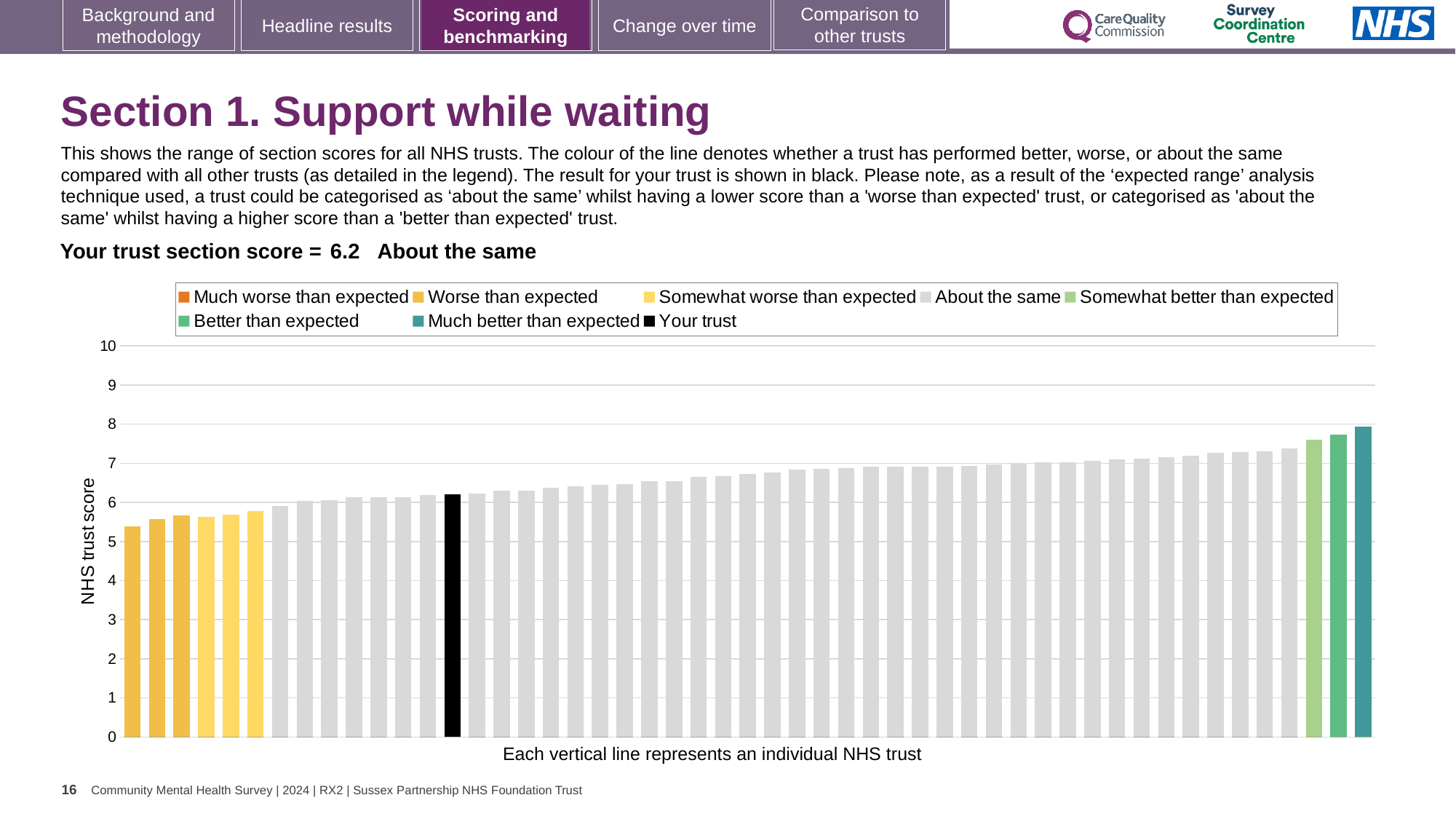
Is the value of the shortest bar in the chart greater or less than 6? less What colour is the bar representing your trust? Black Which legend category does the tallest bar in the chart belong to? Much better than expected What type of chart is shown on the slide? Bar chart Which benchmarking category is your trust's section score placed in? About the same Is the value of the black 'Your trust' bar greater or less than 6? greater What is the section score for your trust shown on the slide? 6.2 How many entries does the chart legend list? 8 How many bars are coloured in the 'Worse than expected' yellow shade? 3 What is the label on the vertical axis of the chart? NHS trust score Is the value of the tallest bar in the chart greater or less than 7? greater Do the bar values rise or fall moving from left to right along the x axis? Rise